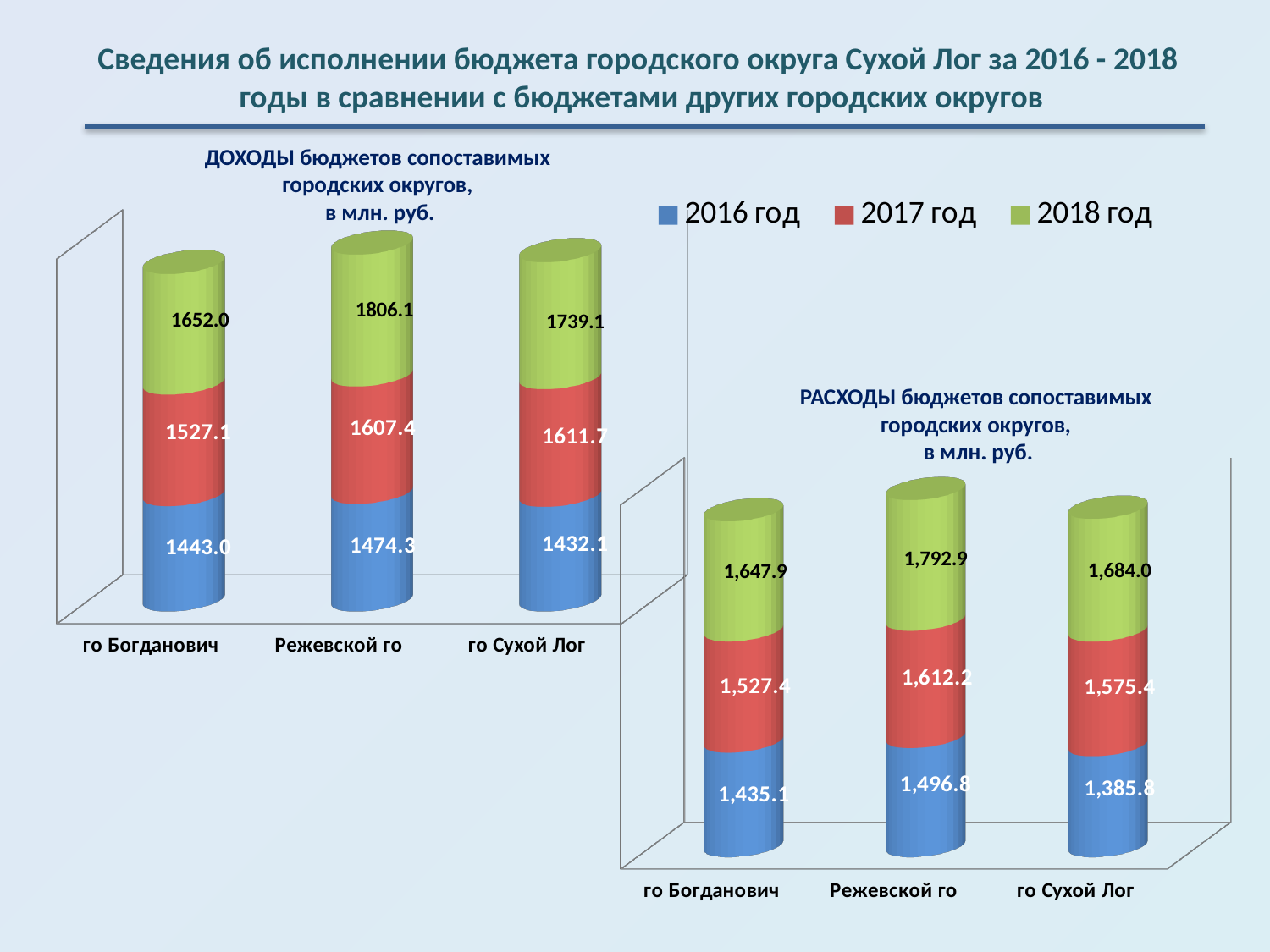
In the РАСХОДЫ (expenditures) chart, what is the total of the stacked bar for го Сухой Лог? 4,645.2 What kind of chart is the РАСХОДЫ (expenditures) chart? Stacked bar chart How many series does the legend list? 3 In the ДОХОДЫ (revenues) chart, what is the total of the stacked bar for Режевской го? 4887.8 In the ДОХОДЫ (revenues) chart, which city district has the highest 2018 год value? Режевской го How many city districts are shown in the ДОХОДЫ (revenues) chart? 3 In the ДОХОДЫ (revenues) chart, what is the value for го Сухой Лог in 2018 год? 1739.1 In the ДОХОДЫ (revenues) chart, what is the difference between the 2018 год and 2016 год values for го Богданович? 209.0 In the РАСХОДЫ (expenditures) chart, which city district has the lowest 2016 год value? го Сухой Лог In the РАСХОДЫ (expenditures) chart, what is the value for Режевской го in 2016 год? 1,496.8 Which colour represents 2017 год in the legend? Red In the РАСХОДЫ (expenditures) chart, which is larger for го Сухой Лог: the 2017 год value or the 2016 год value? 2017 год